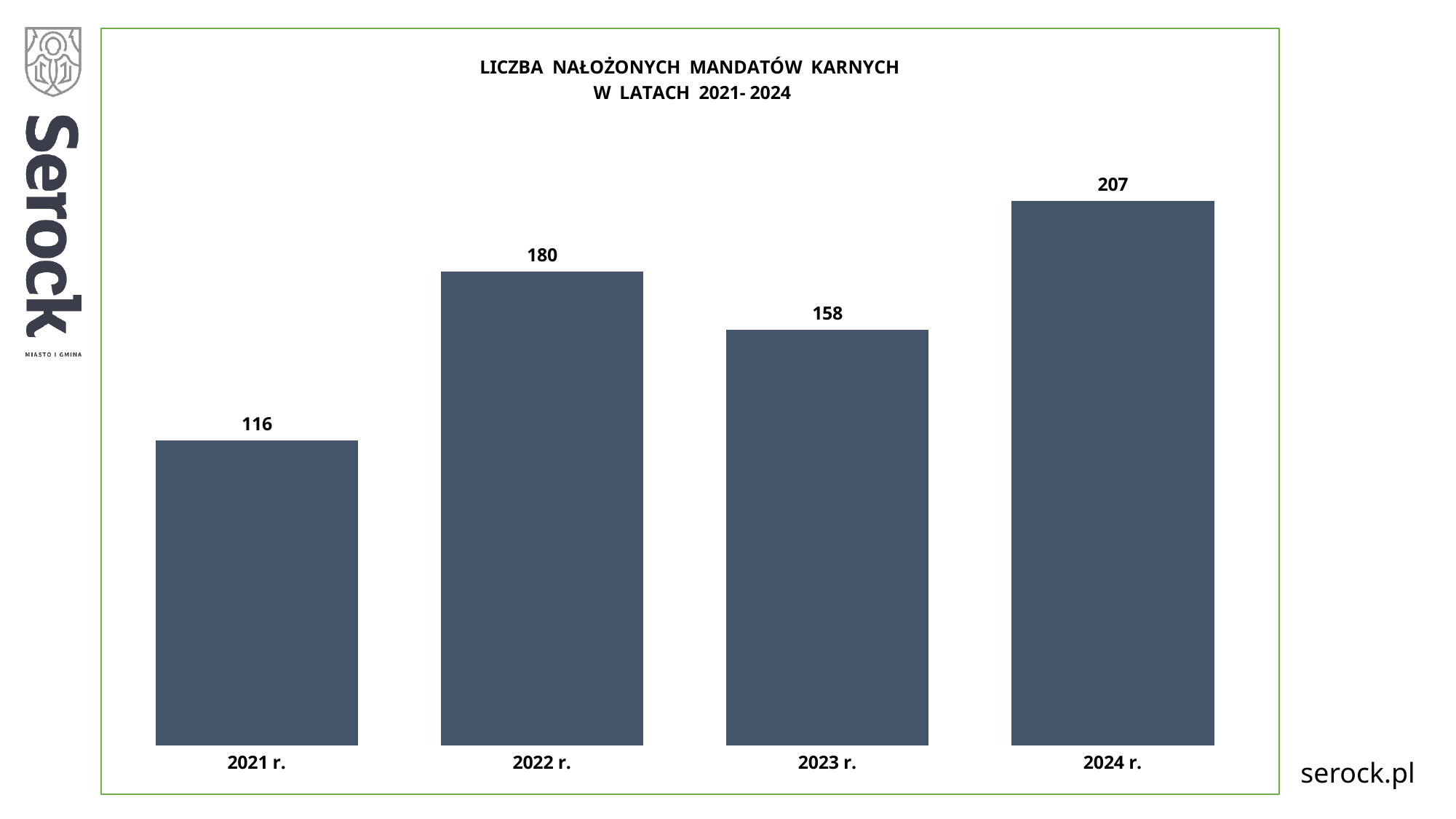
What is the difference between the values for 2022 r. and 2023 r.? 22 What is the title of the chart? LICZBA NAŁOŻONYCH MANDATÓW KARNYCH W LATACH 2021-2024 How many years are shown on the chart? 4 Which is larger, the value for 2022 r. or the value for 2023 r.? 2022 r. Which year has the highest value? 2024 r. What is the value for 2021 r.? 116 What is the value for 2022 r.? 180 What is the value for 2023 r.? 158 What kind of chart is shown on the slide? bar chart Which year has the lowest value? 2021 r. What is the difference between the values for 2024 r. and 2021 r.? 91 What is the value for 2024 r.? 207